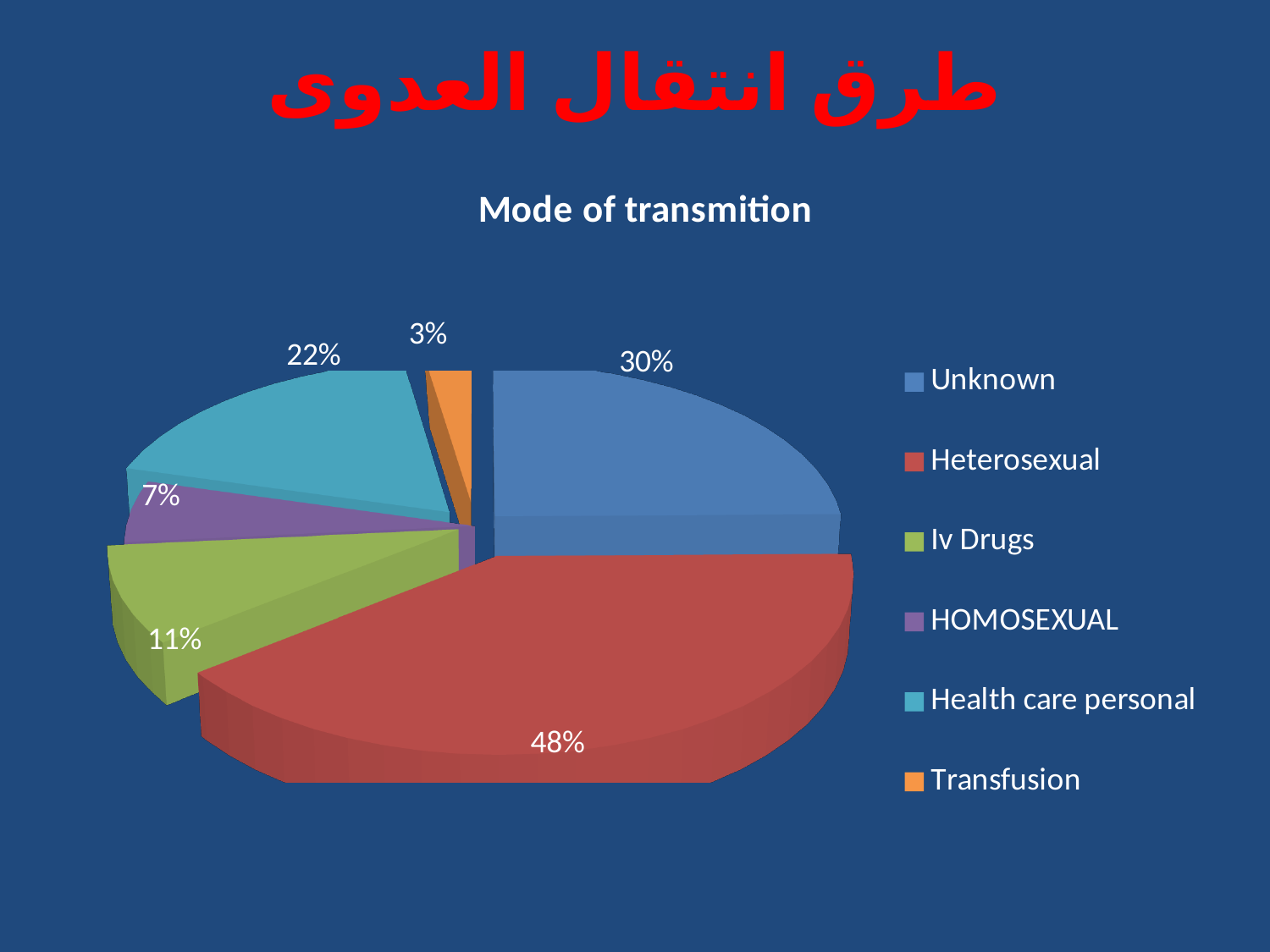
What percentage is shown for Heterosexual? 48% Which category has the largest slice? Heterosexual What is the chart's title? Mode of transmition What percentage is shown for Unknown? 30% What percentage is shown for Transfusion? 3% What kind of chart is shown on the slide? pie chart How many categories does the legend list? 6 Which is larger, the slice for Unknown or the slice for Health care personal? Unknown What is the difference in percentage points between the Heterosexual slice and the HOMOSEXUAL slice? 41 What percentage is shown for Iv Drugs? 11% Which category has the smallest slice? Transfusion What percentage is shown for Health care personal? 22%